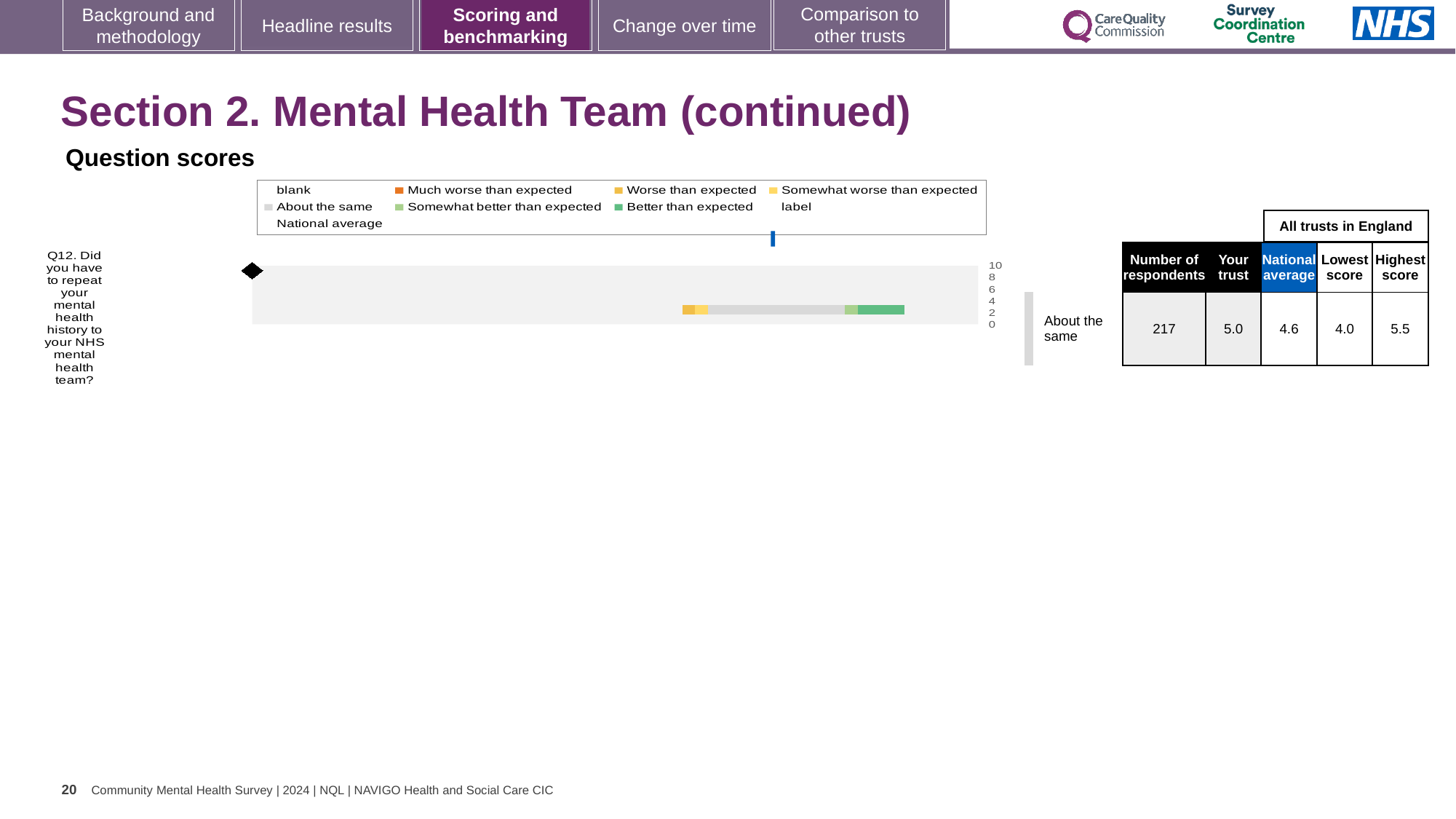
What is the highest score among all trusts in England for Q12? 5.5 What kind of chart is used to show the Q12 question score? bar chart What is the lowest score among all trusts in England for Q12? 4.0 How many survey questions are plotted on the chart? 1 How many respondents answered Q12? 217 Which is larger for Q12, the 'Your trust' score or the national average? Your trust What is the difference between the highest and lowest scores for Q12? 1.5 Which colour in the chart legend represents 'Better than expected'? green What benchmark label is shown next to the bar for Q12? About the same By how much does the 'Your trust' score for Q12 exceed the national average? 0.4 What is the national average score for Q12? 4.6 What is the 'Your trust' score for Q12? 5.0